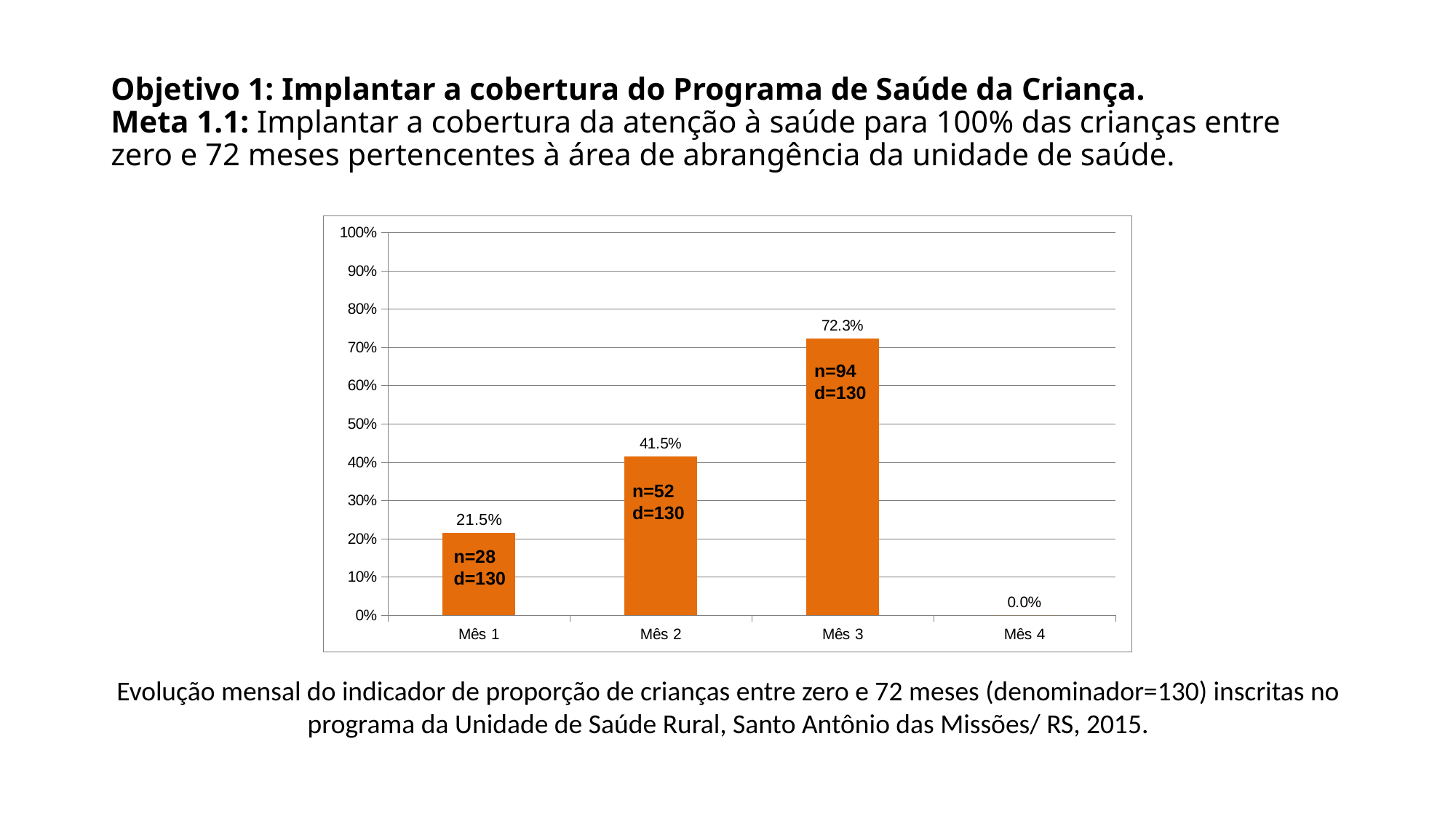
What is the value for Mês 4? 0.0% Is the value for Mês 3 greater or less than 70%? greater What is the difference between the values for Mês 3 and Mês 2? 30.8% Which month has the highest value? Mês 3 What is the value for Mês 2? 41.5% How many months are shown on the x axis? 4 What is the n value labelled on the bar for Mês 2? n=52 Which is larger, the value for Mês 1 or the value for Mês 2? Mês 2 What is the value for Mês 3? 72.3% What is the value for Mês 1? 21.5% What kind of chart is shown on the slide? bar chart Which month has the lowest value? Mês 4